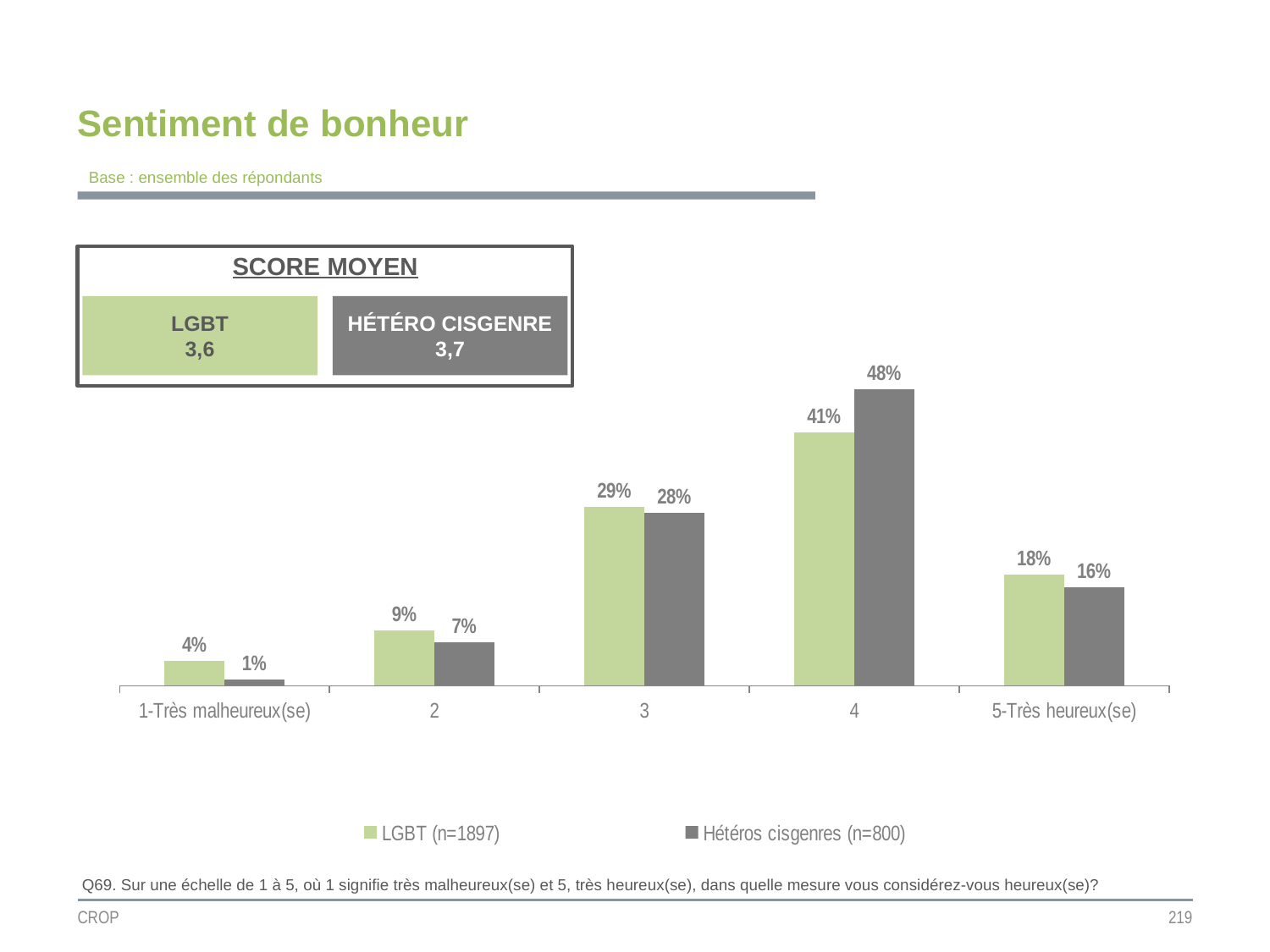
What is the difference between the Hétéros cisgenres (n=800) and LGBT (n=1897) values at category 4? 7% What is the title of the slide? Sentiment de bonheur Which category has the highest value for Hétéros cisgenres (n=800)? 4 Which category has the lowest value for LGBT (n=1897)? 1-Très malheureux(se) What is the difference between the LGBT (n=1897) and Hétéros cisgenres (n=800) values at category 2? 2% What is the value for Hétéros cisgenres (n=800) at category 5-Très heureux(se)? 16% At category 3, which series has the larger value, LGBT (n=1897) or Hétéros cisgenres (n=800)? LGBT (n=1897) How many categories are shown on the x axis? 5 What kind of chart is shown on the slide? bar chart How many series does the legend list? 2 What is the value for Hétéros cisgenres (n=800) at category 1-Très malheureux(se)? 1% What is the value for LGBT (n=1897) at category 4? 41%